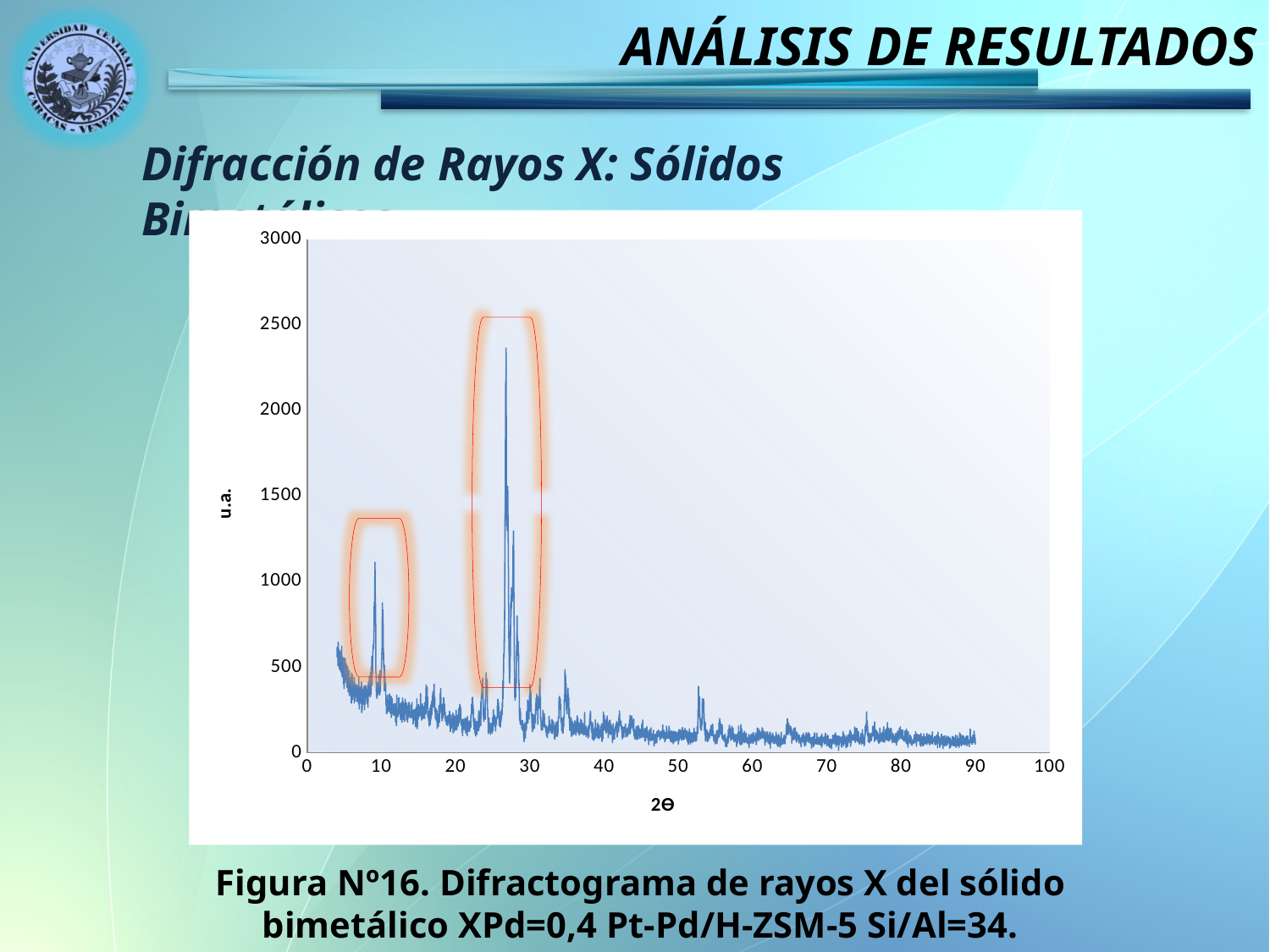
What kind of chart is shown on the slide? line chart Is the tallest peak of the diffractogram greater or less than 2000? greater How many data series are plotted in the chart? 1 Is the signal at 2Θ = 80 greater or less than 500? less Which region of 2Θ contains the tallest peak: around 10 or around 27? around 27 What is the maximum value shown on the y axis of the chart? 3000 How many red highlighted boxes mark peak regions on the chart? 2 What is the label of the x axis of the chart? 2Θ What is the label of the y axis of the chart? u.a. Is the tallest peak in the region around 2Θ = 10 greater or less than 1500? less What is the maximum value shown on the x axis of the chart? 100